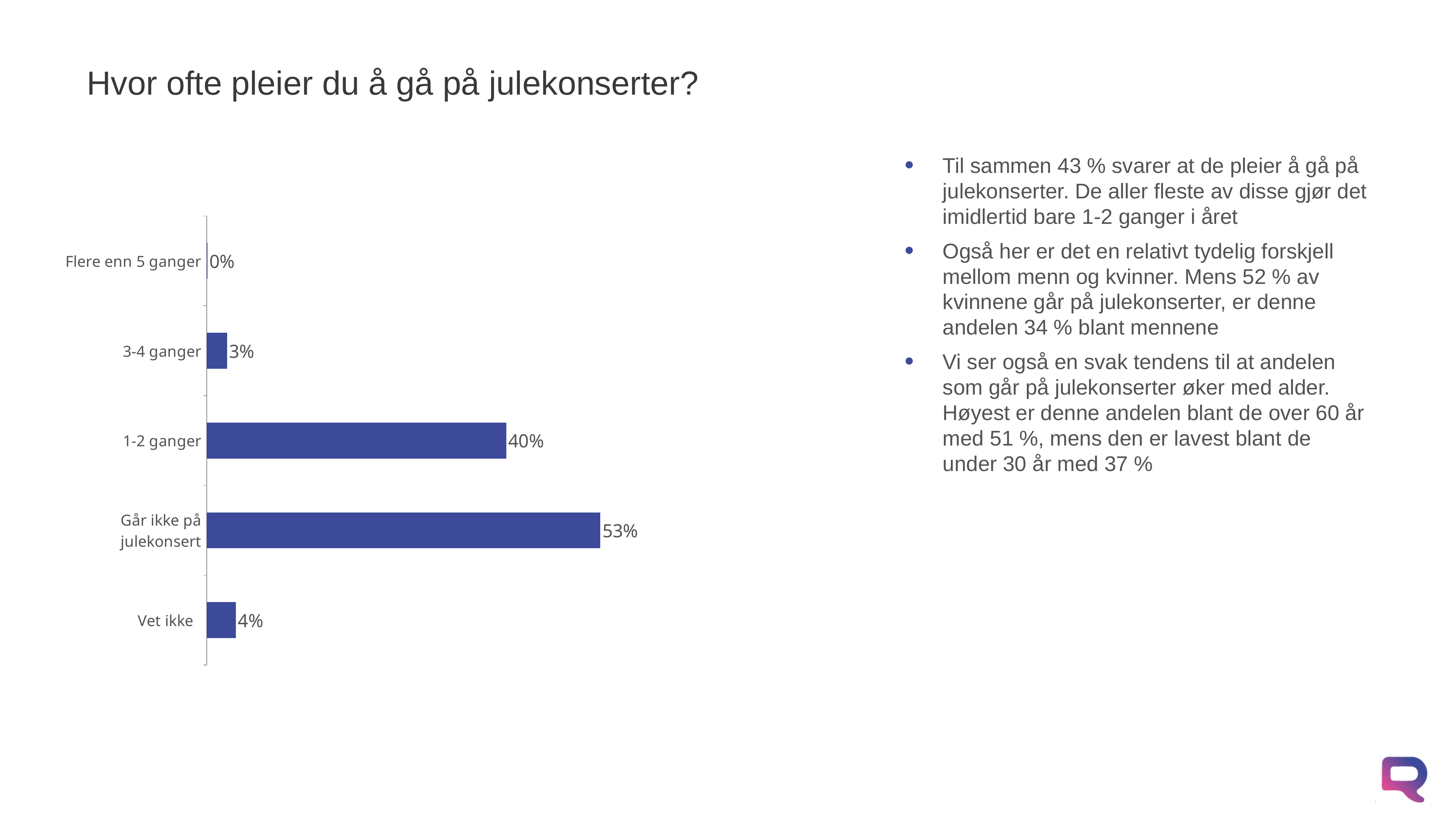
What percentage is shown for "3-4 ganger"? 3% Which category has the highest value? Går ikke på julekonsert What type of chart is shown on the slide? Bar chart What is the title of the slide? Hvor ofte pleier du å gå på julekonserter? What value is shown for "Flere enn 5 ganger"? 0% How many categories are shown in the chart? 5 What percentage of respondents answered "1-2 ganger"? 40% Which is larger, the value for "Vet ikke" or the value for "3-4 ganger"? Vet ikke Which category has the lowest value? Flere enn 5 ganger What is the value for "Vet ikke"? 4% What is the difference between the values for "Går ikke på julekonsert" and "1-2 ganger"? 13% What is the value shown for "Går ikke på julekonsert"? 53%